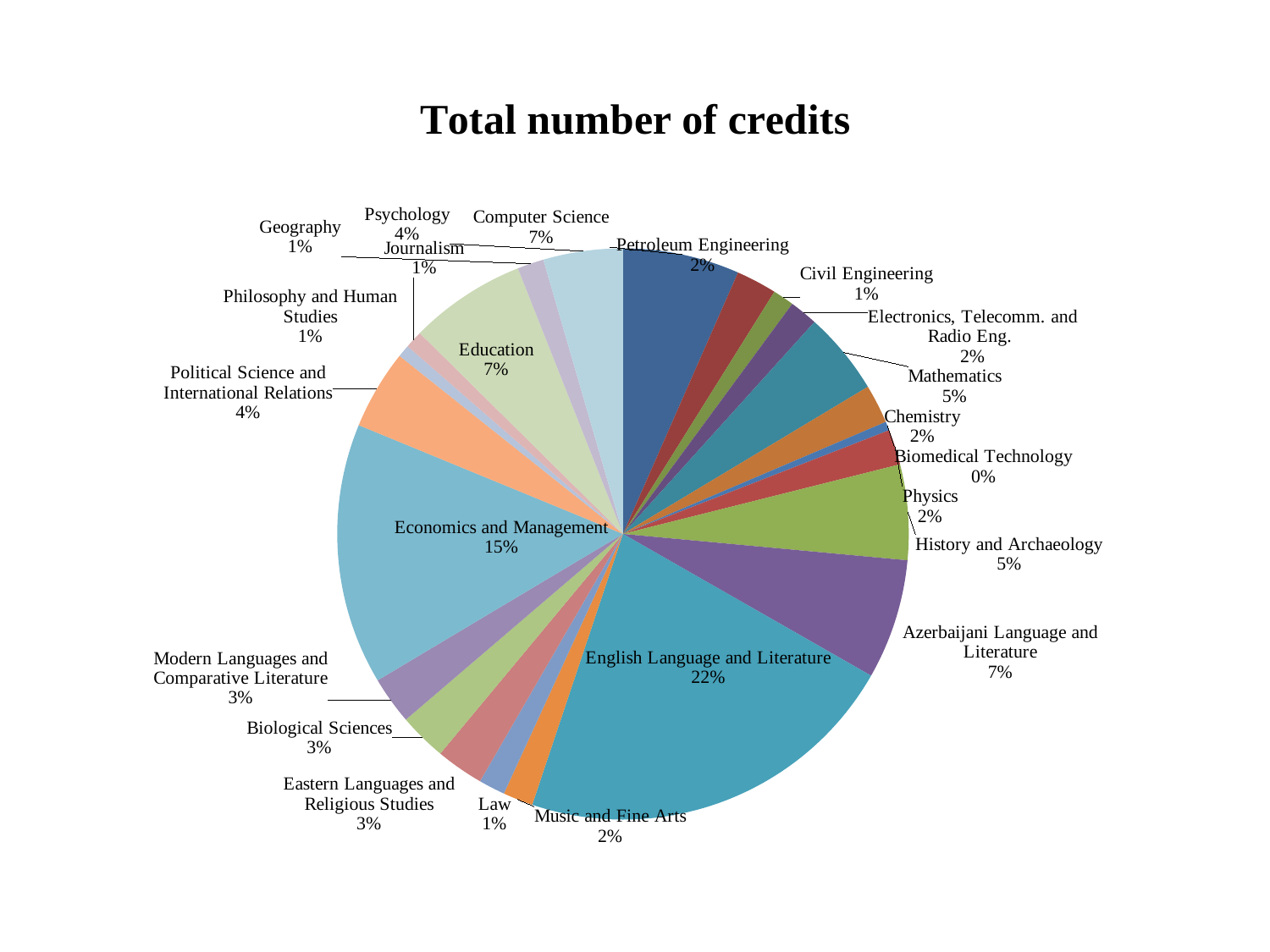
What is the difference in percentage points between English Language and Literature and Economics and Management? 7 percentage points What kind of chart is shown on the slide? pie chart What is the difference in percentage points between Azerbaijani Language and Literature and Law? 6 percentage points Which category has the largest share of the pie? English Language and Literature What percentage is shown for History and Archaeology? 5% What share of the pie does English Language and Literature have? 22% What is the title of the chart? Total number of credits What percentage is shown for Economics and Management? 15% Which has a larger share, Mathematics or Psychology? Mathematics How many categories are shown in the pie chart? 23 Which category has the smallest share of the pie? Biomedical Technology What percentage is shown for Education? 7%